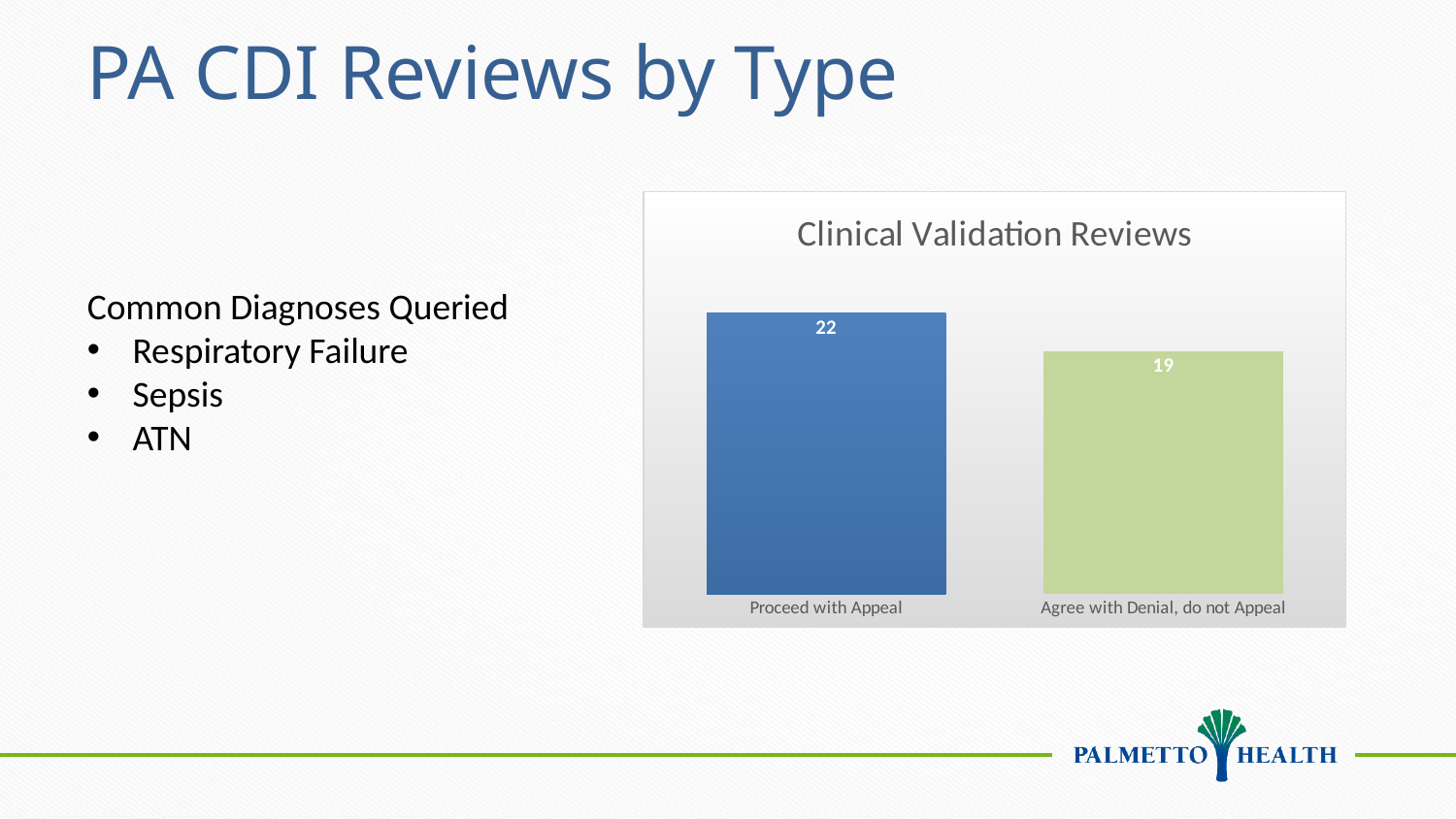
Which category has the lowest value? Agree with Denial, do not Appeal What is the difference between the values for Proceed with Appeal and Agree with Denial, do not Appeal? 3 What kind of chart is shown? Bar chart What colour is the bar for Proceed with Appeal? Blue Which category has the highest value? Proceed with Appeal What is the title of the chart? Clinical Validation Reviews What is the total of the two values shown in the chart? 41 How many categories are shown in the chart? 2 What is the value for Proceed with Appeal? 22 What is the value for Agree with Denial, do not Appeal? 19 Which is larger: Proceed with Appeal or Agree with Denial, do not Appeal? Proceed with Appeal